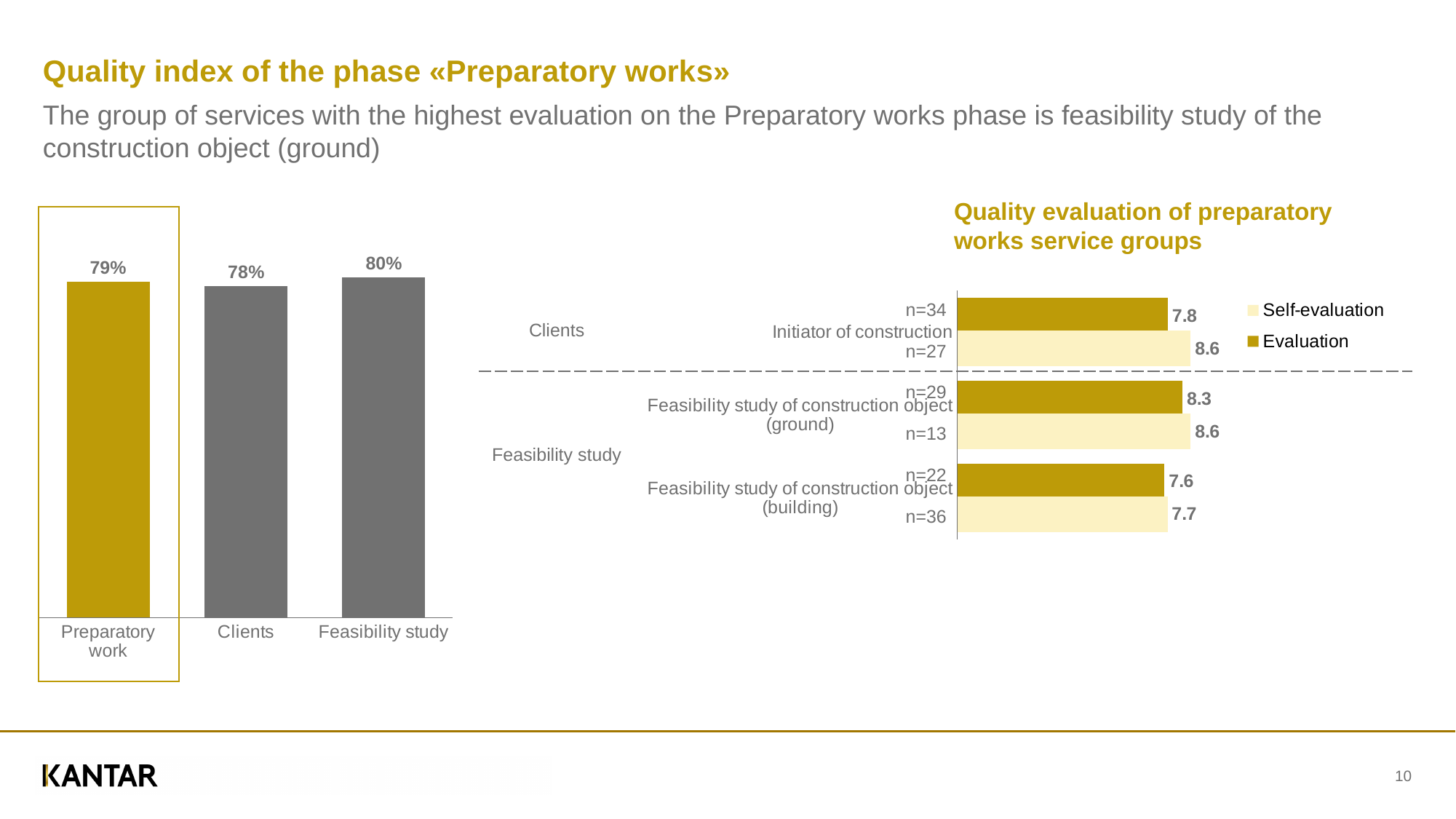
In the left bar chart, what is the value for Feasibility study? 80% In the chart 'Quality evaluation of preparatory works service groups', is the Evaluation value for Initiator of construction larger or smaller than the Evaluation value for Feasibility study of construction object (ground)? smaller In the left bar chart, which category has the highest value? Feasibility study In the chart 'Quality evaluation of preparatory works service groups', what is the Evaluation value for Feasibility study of construction object (ground)? 8.3 In the left bar chart, what is the value for Clients? 78% In the left bar chart, which category has the lowest value? Clients In the chart 'Quality evaluation of preparatory works service groups', what is the difference between the Self-evaluation and Evaluation values for Initiator of construction? 0.8 What kind of chart is the chart 'Quality evaluation of preparatory works service groups'? bar chart In the left bar chart, how many categories are shown? 3 In the chart 'Quality evaluation of preparatory works service groups', what is the Self-evaluation value for Initiator of construction? 8.6 In the chart 'Quality evaluation of preparatory works service groups', how many series does the legend list? 2 In the chart 'Quality evaluation of preparatory works service groups', which service group has the lowest Evaluation value? Feasibility study of construction object (building)